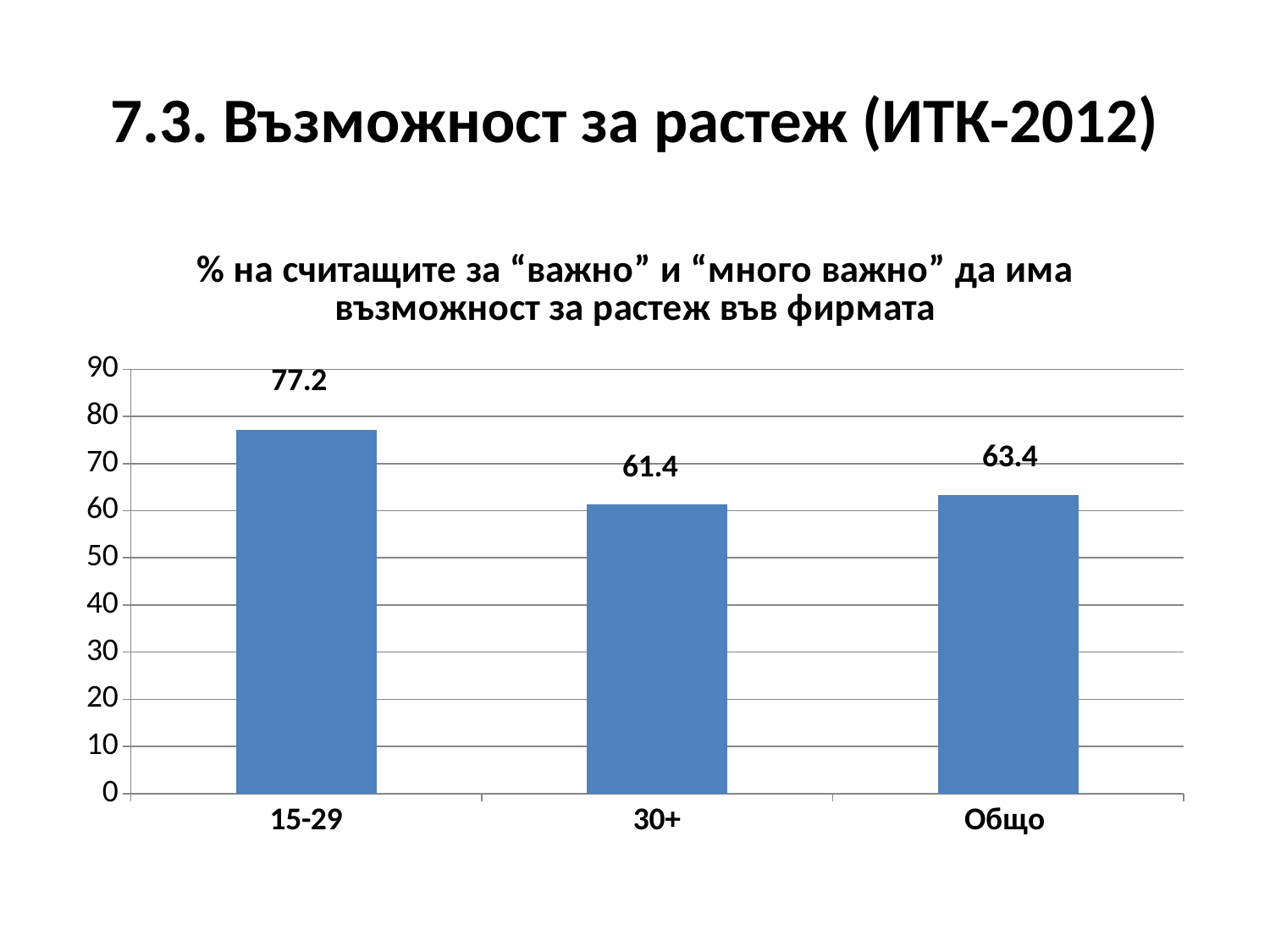
What is the difference between the values for Общо and 30+? 2 What is the value for the 15-29 category? 77.2 How many categories are shown on the x axis? 3 What is the highest value shown on the y axis? 90 What is the value for the Общо category? 63.4 What is the value for the 30+ category? 61.4 Which category has the lowest value? 30+ Is the value for 30+ greater or less than 70? less Which is larger, the value for 15-29 or the value for Общо? 15-29 What kind of chart is shown on the slide? bar chart Which category has the highest value? 15-29 What is the difference between the values for 15-29 and 30+? 15.8